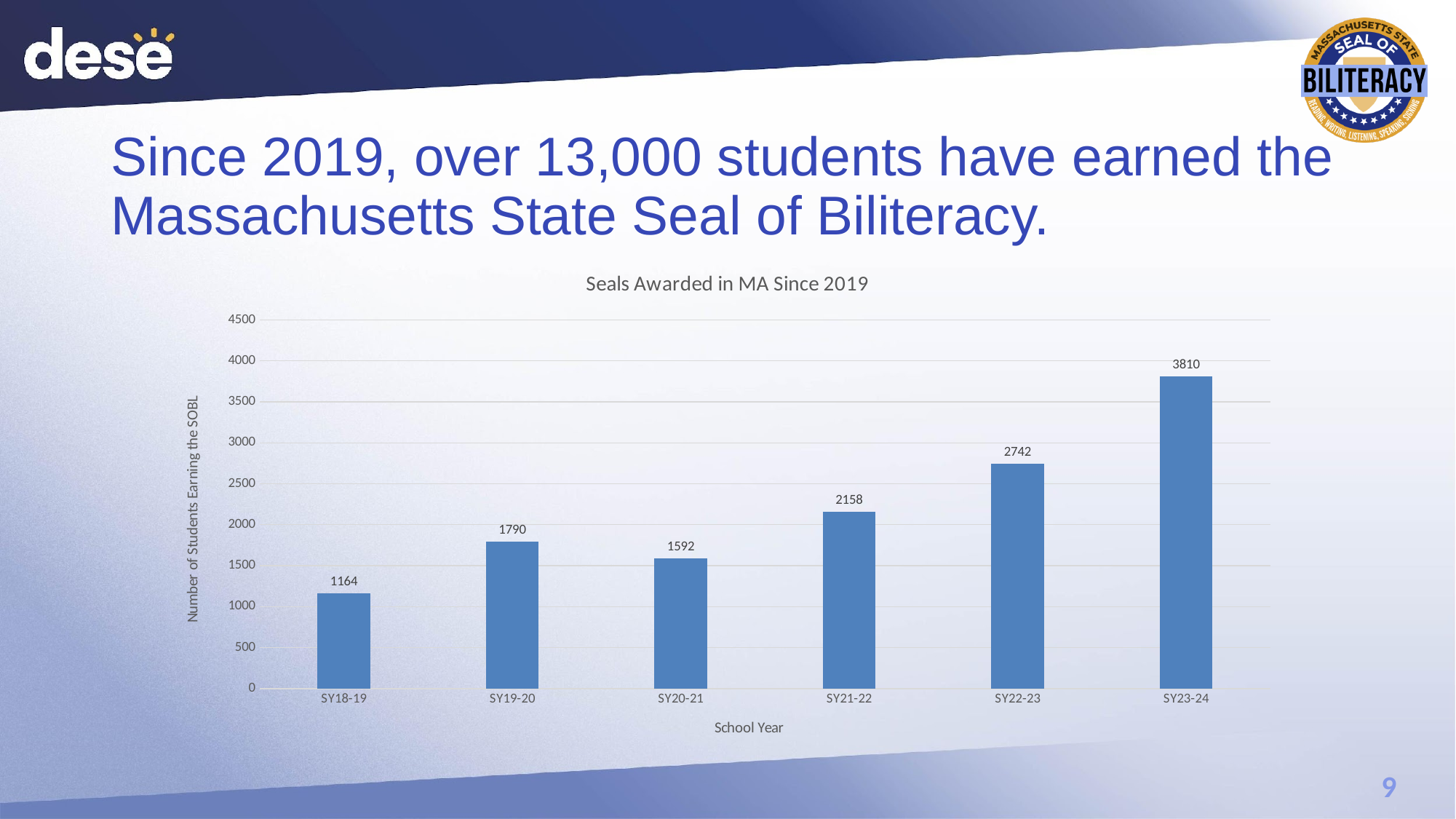
What kind of chart is shown on the slide? Bar chart Which school year has the lowest number of students earning the SOBL? SY18-19 What is the difference between the values for SY19-20 and SY20-21? 198 What is the difference between the values for SY23-24 and SY22-23? 1068 Which school year has the highest number of students earning the SOBL? SY23-24 Which is larger, the value for SY19-20 or the value for SY20-21? SY19-20 What is the value shown for SY18-19? 1164 How many students earned the Seal of Biliteracy in SY23-24? 3810 What is the title of the chart? Seals Awarded in MA Since 2019 Is the value for SY21-22 greater or less than 2000? greater How many school years are shown on the x axis? 6 What is the value shown for SY20-21? 1592